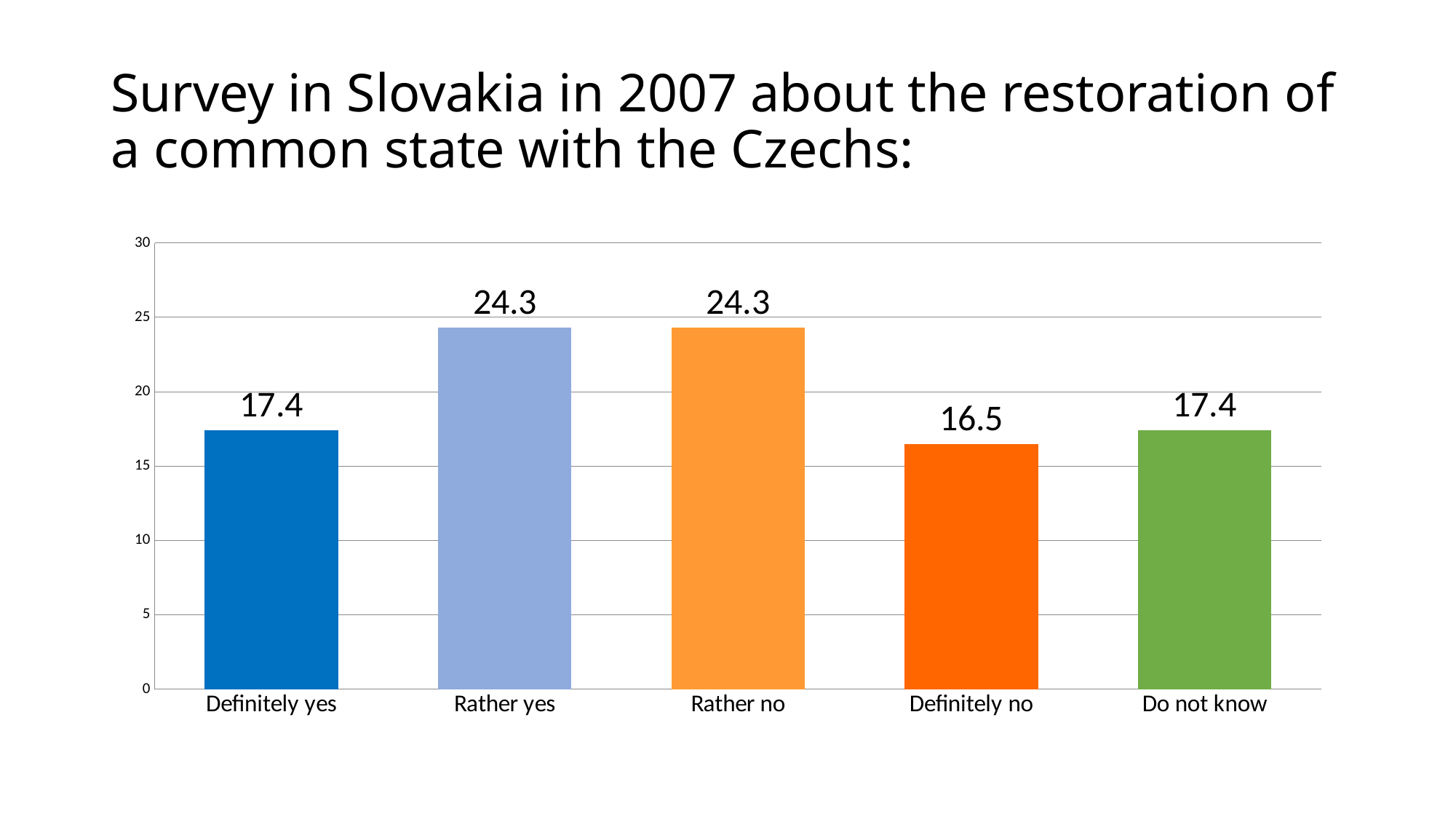
Which category has the lowest value? Definitely no What is the title of the slide? Survey in Slovakia in 2007 about the restoration of a common state with the Czechs: Is the value for Rather no greater or less than 20? greater How many categories are shown on the x axis? 5 What is the value for Rather yes? 24.3 What is the value for Do not know? 17.4 What is the value for Definitely no? 16.5 What is the difference between the values for Rather no and Definitely no? 7.8 What is the value for Definitely yes? 17.4 What kind of chart is shown on the slide? bar chart Which is larger, the value for Rather yes or the value for Do not know? Rather yes What is the difference between the values for Rather yes and Definitely yes? 6.9